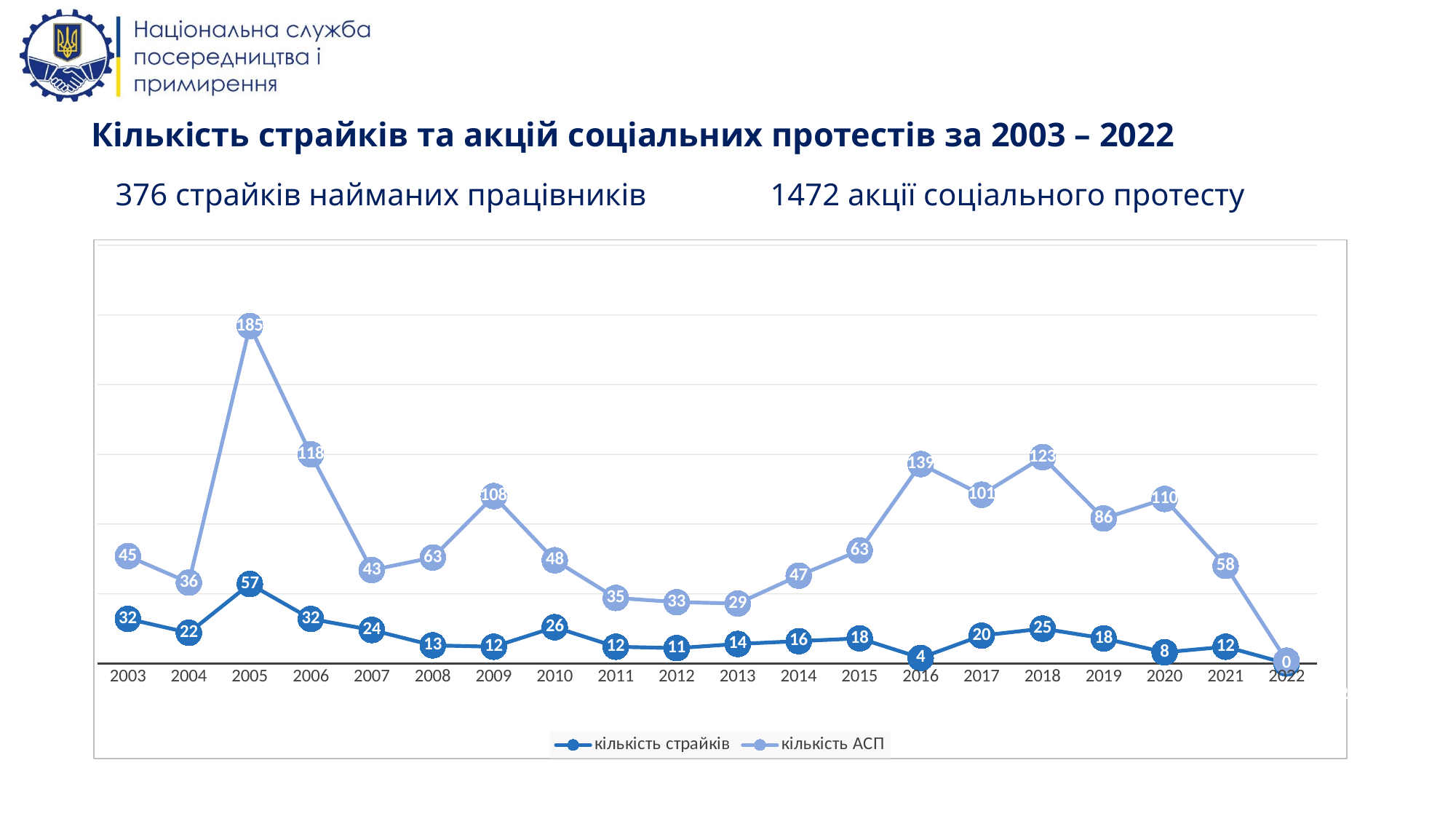
What is the value of кількість страйків in 2018? 25 In which year is кількість страйків highest? 2005 What is the value of кількість страйків in 2016? 4 What is the value of кількість АСП in 2005? 185 How many years are plotted along the x axis? 20 In which year is кількість АСП highest? 2005 What is the difference between кількість АСП in 2016 and in 2017? 38 Which is larger: кількість АСП in 2018 or in 2020? 2018 Does кількість АСП rise or fall from 2018 to 2019? fall What type of chart is shown on the slide? line chart How many series does the legend list? 2